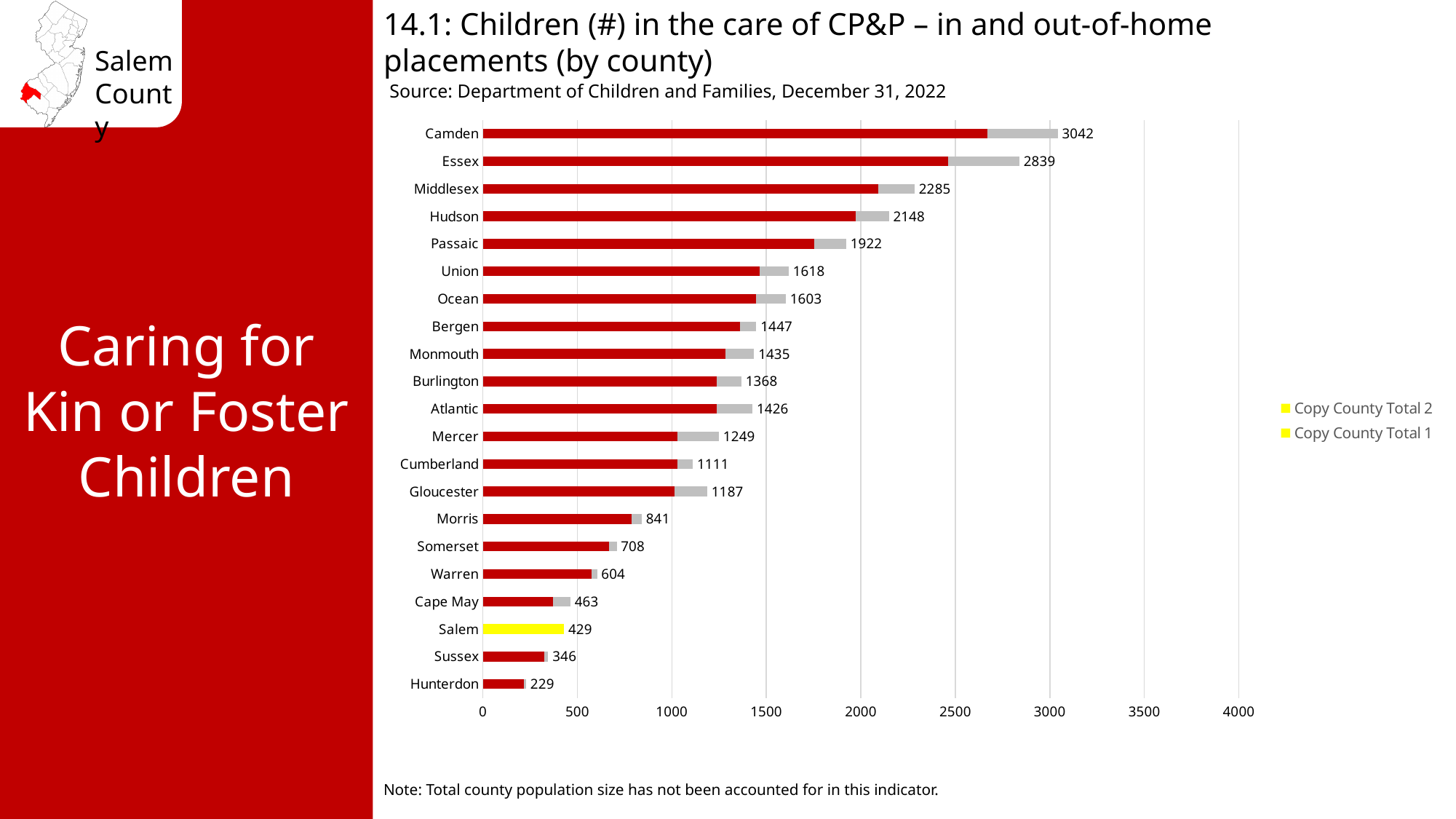
What is the value shown for Salem County? 429 What is the total number of children in the care of CP&P for Camden County? 3042 Which has a larger value, Atlantic or Burlington? Atlantic Which county has the lowest number of children in the care of CP&P? Hunterdon Is the red segment of the Camden bar greater or less than 2500? greater What is the difference between the values for Salem and Sussex? 83 What is the difference between the values for Camden and Essex? 203 What kind of chart is shown on the slide? Bar chart What is the value shown for Mercer County? 1249 How many series does the legend list? 2 Which county has the highest number of children in the care of CP&P? Camden How many counties are shown in the chart? 21